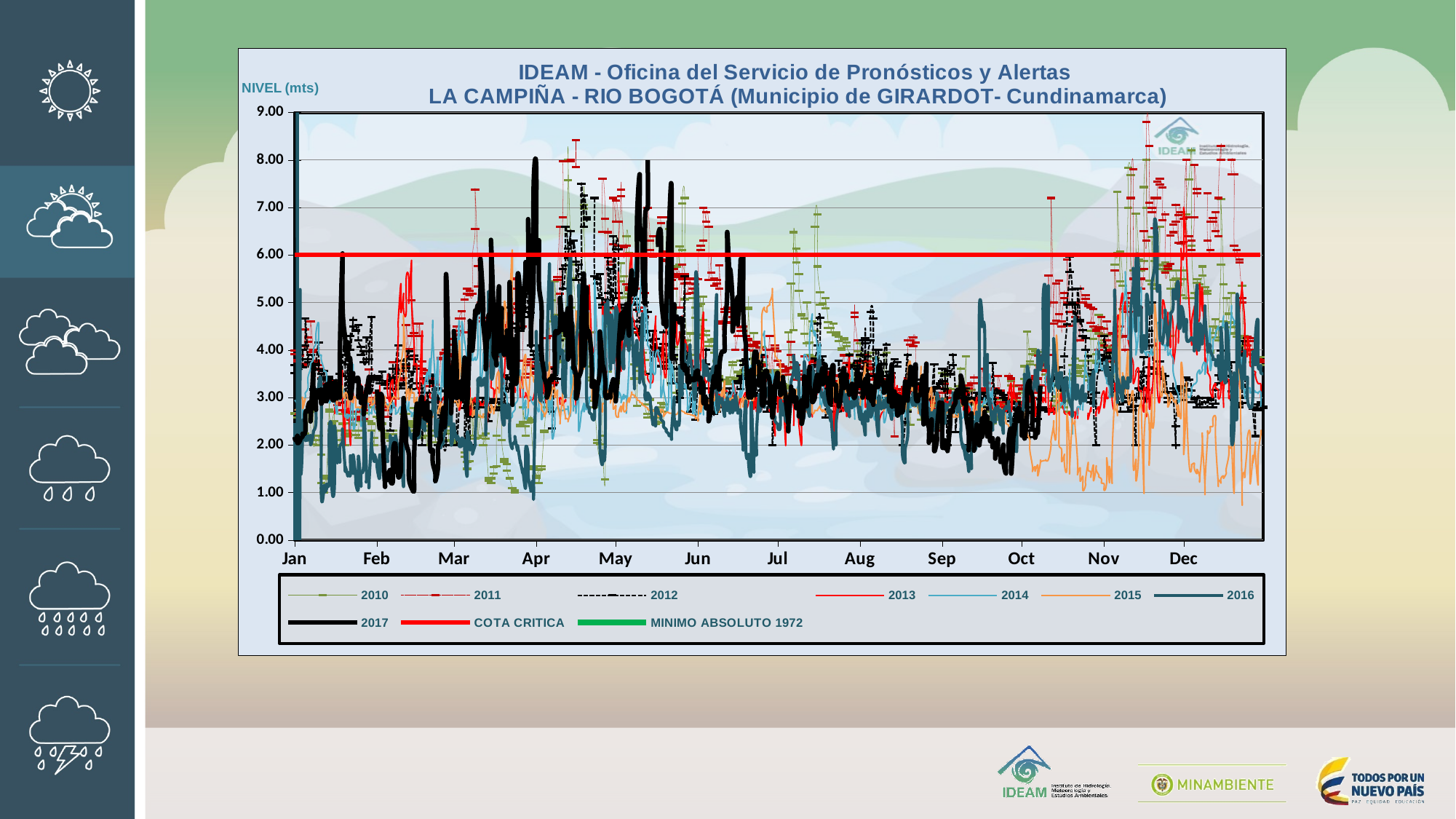
How many months are labelled along the x axis of the chart? 12 Which station and river does the chart title say the data is for? LA CAMPIÑA - RIO BOGOTÁ Is the peak value of the 2017 series in May greater or less than 7.00? greater What kind of chart is shown on the slide? line chart What is the label of the vertical axis of the chart? NIVEL (mts) What colour is the COTA CRITICA line in the chart? red Is the value of the 2017 series at the start of January greater or less than 3.00? less What is the highest value shown on the vertical axis of the chart? 9.00 How many entries does the chart legend list? 10 Which year in the legend is labelled MINIMO ABSOLUTO? 1972 Is the value of the 2015 series in December greater or less than 3.00? less At what level (in mts) is the COTA CRITICA line drawn on the chart? 6.00